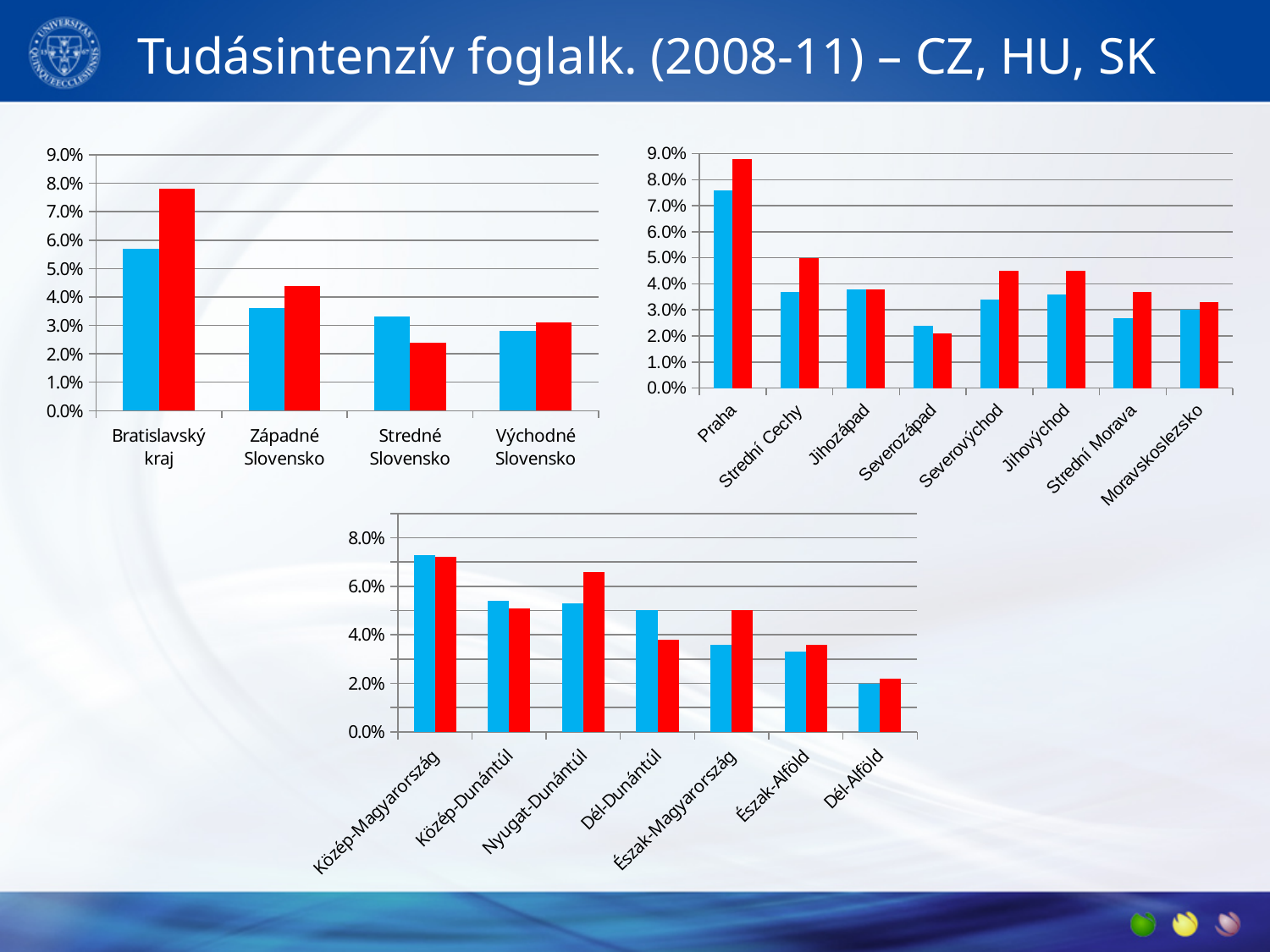
How many regions are shown on the x axis of the bottom chart (Közép-Magyarország to Dél-Alföld)? 7 How many regions are shown on the x axis of the top-left chart (Bratislavský kraj to Východné Slovensko)? 4 In the top-left chart, which region has the highest bars? Bratislavský kraj In the top-right chart, which region has the highest bars? Praha In the bottom chart, is the blue bar for Dél-Alföld greater or less than 4.0%? less In the top-right chart, is the red bar for Praha greater or less than 8.0%? greater What type of chart is the top-left chart (Slovak regions)? bar chart How many regions are shown on the x axis of the top-right chart (Praha to Moravskoslezsko)? 8 In the top-right chart, which region has taller bars, Praha or Severozápad? Praha In the bottom chart, which region has the lowest bars? Dél-Alföld In the top-left chart, is the red bar for Bratislavský kraj greater or less than 7.0%? greater In the top-left chart, for Stredné Slovensko, which bar is taller, the blue one or the red one? the blue one